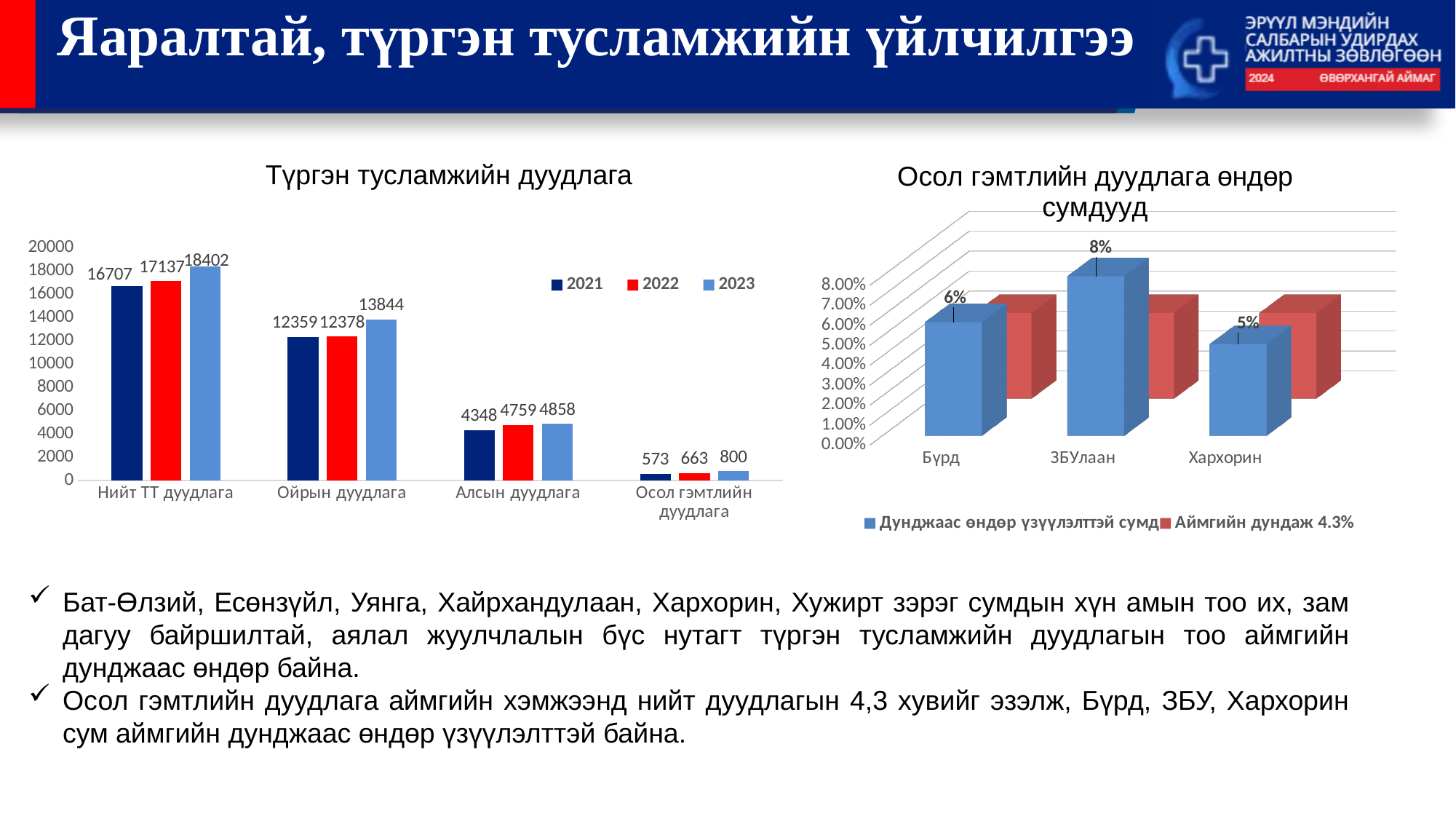
In the chart titled "Түргэн тусламжийн дуудлага", what is the 2021 value for Ойрын дуудлага? 12359 In the chart titled "Осол гэмтлийн дуудлага өндөр сумдууд", which is larger, the value for Бүрд or the value for ЗБУлаан? ЗБУлаан In the chart titled "Түргэн тусламжийн дуудлага", how many series does the legend list? 3 In the chart titled "Түргэн тусламжийн дуудлага", what is the difference between the 2023 and 2021 values for Нийт ТТ дуудлага? 1695 In the chart titled "Осол гэмтлийн дуудлага өндөр сумдууд", which sum has the lowest value? Хархорин In the chart titled "Түргэн тусламжийн дуудлага", what is the 2023 value for Нийт ТТ дуудлага? 18402 In the chart titled "Осол гэмтлийн дуудлага өндөр сумдууд", what is the value for ЗБУлаан? 8% What kind of chart is the one titled "Осол гэмтлийн дуудлага өндөр сумдууд"? bar chart In the chart titled "Түргэн тусламжийн дуудлага", how many categories are shown on the x axis? 4 In the chart titled "Түргэн тусламжийн дуудлага", which category has the lowest values? Осол гэмтлийн дуудлага In the chart titled "Түргэн тусламжийн дуудлага", what is the 2022 value for Осол гэмтлийн дуудлага? 663 In the chart titled "Түргэн тусламжийн дуудлага", do the values for Алсын дуудлага rise or fall from 2021 to 2023? rise